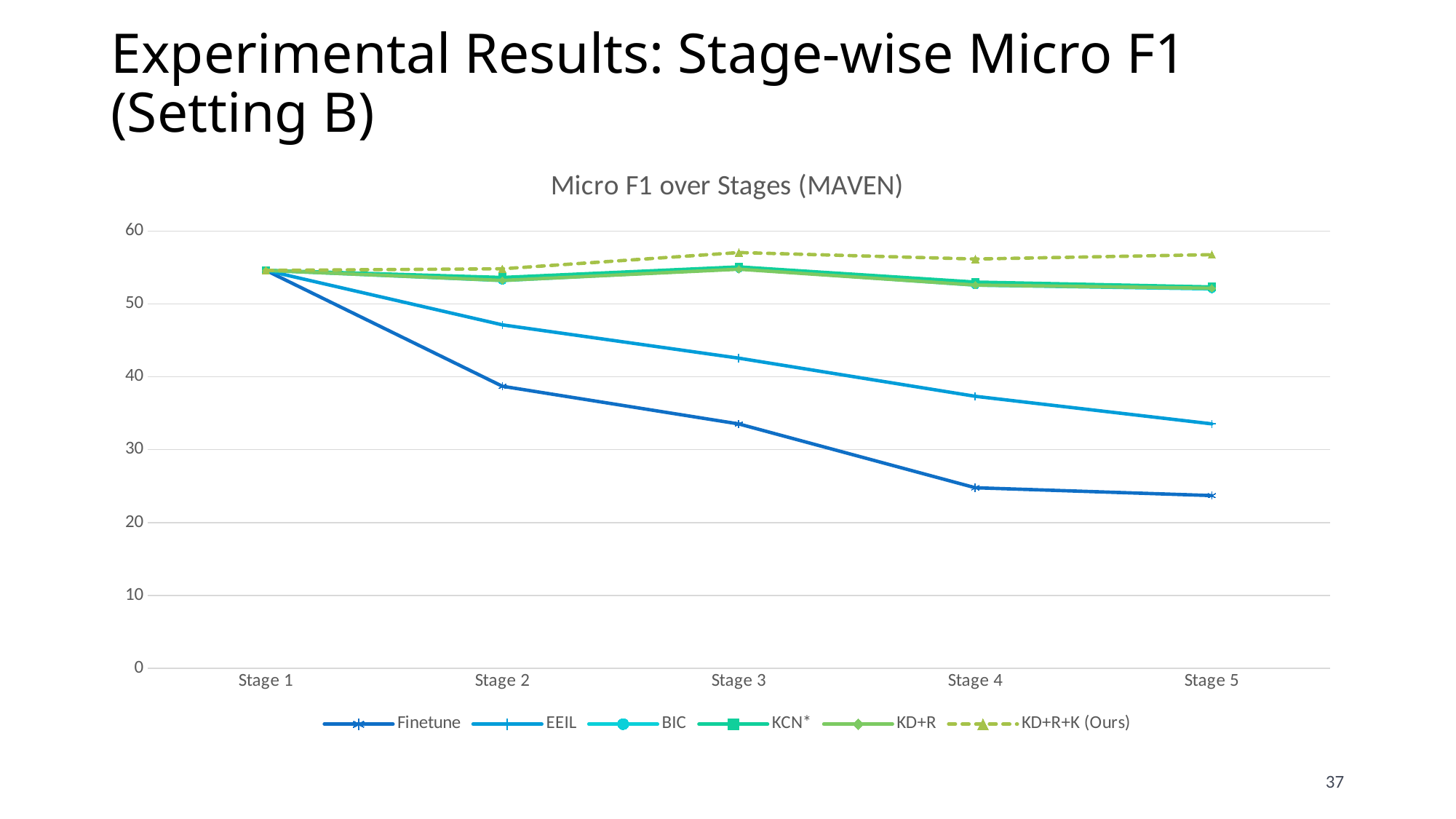
Does the Finetune series rise or fall from Stage 1 to Stage 5? fall Does the EEIL series rise or fall from Stage 1 to Stage 5? fall What kind of chart is shown on the slide? line chart Which series is drawn with a dashed line? KD+R+K (Ours) Is the value for Finetune at Stage 5 greater or less than 30? less Which series has the highest value at Stage 5? KD+R+K (Ours) What is the title of the chart? Micro F1 over Stages (MAVEN) At Stage 4, which is larger, the value for EEIL or the value for Finetune? EEIL How many series does the legend list? 6 Is the value for EEIL at Stage 2 greater or less than 40? greater How many stages are shown on the x axis? 5 Which series has the lowest value at Stage 5? Finetune